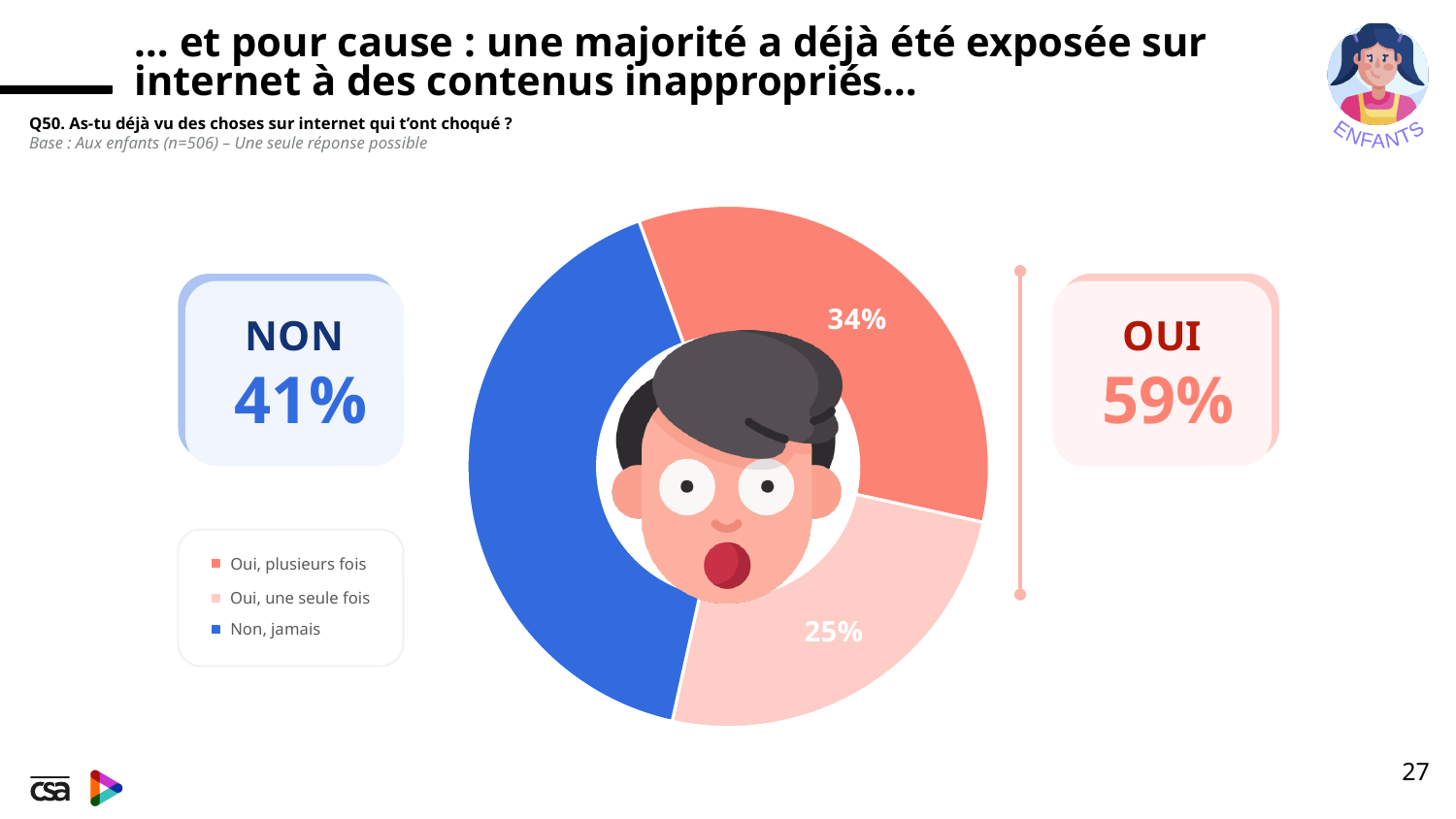
What colour is the "Non, jamais" slice of the pie chart? Blue How many categories does the legend of the pie chart list? 3 What percentage of children answered "Oui, plusieurs fois"? 34% Which answer category has the largest share of the pie? Non, jamais What percentage of children answered "Non, jamais"? 41% What kind of chart is shown on the slide? Pie chart What is the difference between the OUI total and the NON share? 18 percentage points Which is larger: the share for "Oui, plusieurs fois" or the share for "Oui, une seule fois"? Oui, plusieurs fois What percentage of children answered "Oui, une seule fois"? 25% What is the combined share of the two "Oui" answers (OUI total)? 59% Which answer category has the smallest share of the pie? Oui, une seule fois What is the difference between the share for "Oui, plusieurs fois" and the share for "Oui, une seule fois"? 9 percentage points